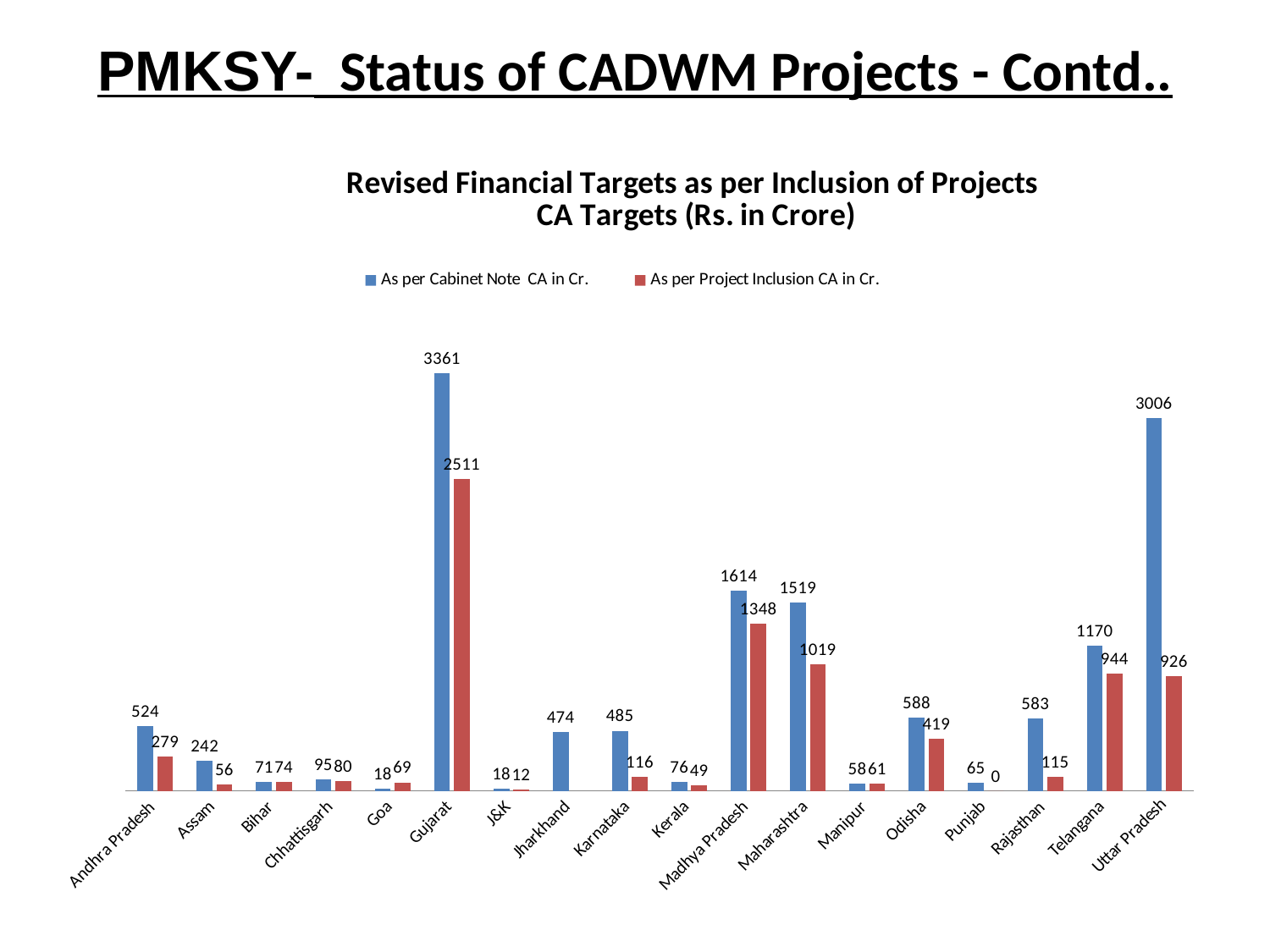
How many states are shown on the x axis of the chart? 18 What kind of chart is shown on the slide? Bar chart What is the value for Telangana in the 'As per Cabinet Note CA in Cr.' series? 1170 What is the difference between the 'As per Cabinet Note' and 'As per Project Inclusion' values for Gujarat? 850 What colour represents the 'As per Project Inclusion CA in Cr.' series in the chart? Red Which state has the highest value in the 'As per Cabinet Note CA in Cr.' series? Gujarat Which state has the lowest value in the 'As per Project Inclusion CA in Cr.' series? Punjab Which has the larger 'As per Cabinet Note CA in Cr.' value, Madhya Pradesh or Maharashtra? Madhya Pradesh How many series does the chart legend list? 2 What is the value for Gujarat in the 'As per Cabinet Note CA in Cr.' series? 3361 What is the difference between the 'As per Cabinet Note' and 'As per Project Inclusion' values for Uttar Pradesh? 2080 What is the value for Uttar Pradesh in the 'As per Project Inclusion CA in Cr.' series? 926